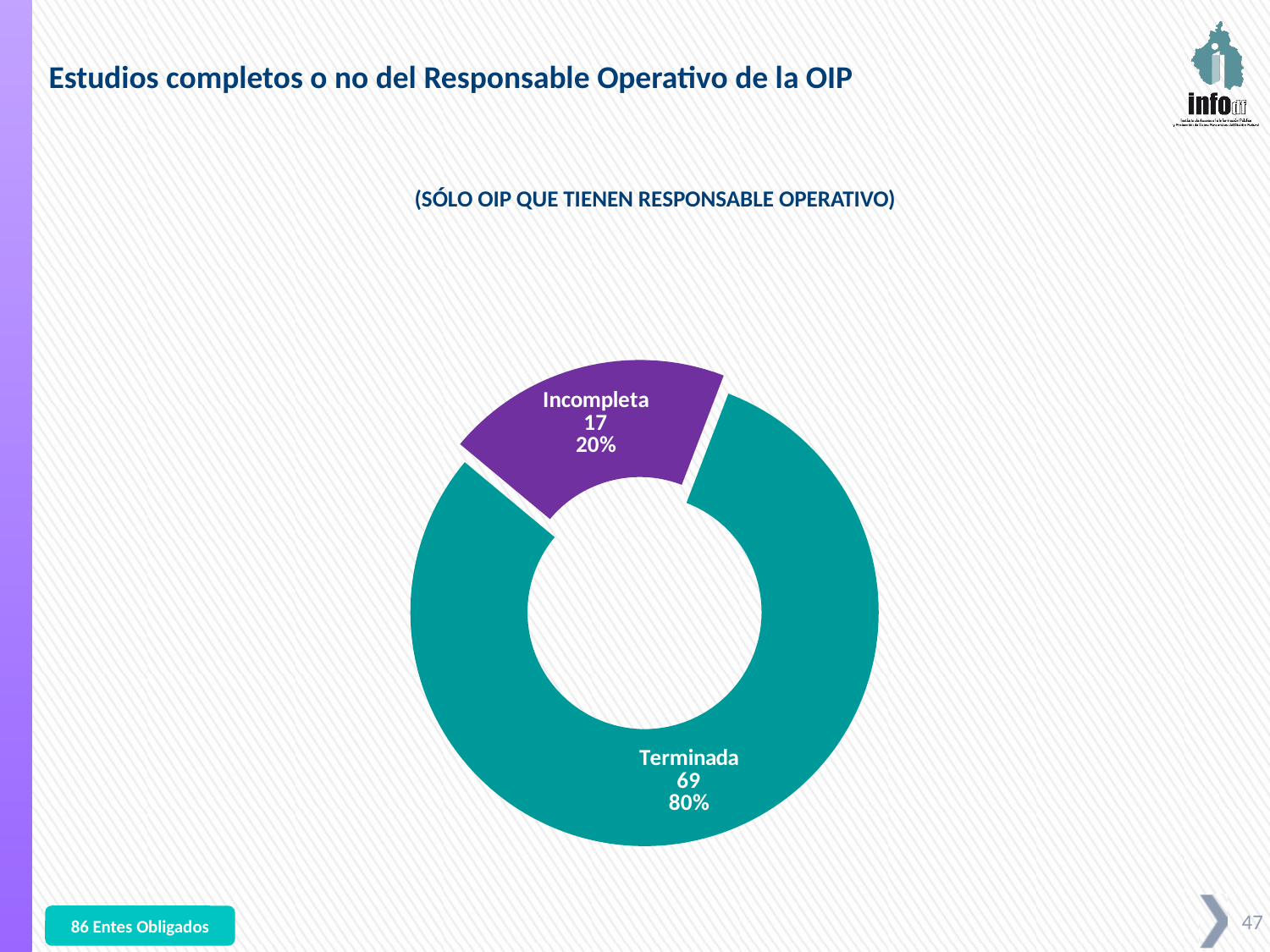
What is the value for Incompleta? 17 What is the difference between the values for Terminada and Incompleta? 52 What is the value for Terminada? 69 What percentage share does Incompleta have? 20% What kind of chart is shown on the slide? Pie chart (doughnut) What colour is the Incompleta slice? Purple What is the total of the two values shown in the chart? 86 Which is larger, Terminada or Incompleta? Terminada What percentage share does Terminada have? 80% Which category has the highest value? Terminada Which category has the lowest value? Incompleta How many categories are shown in the chart? 2